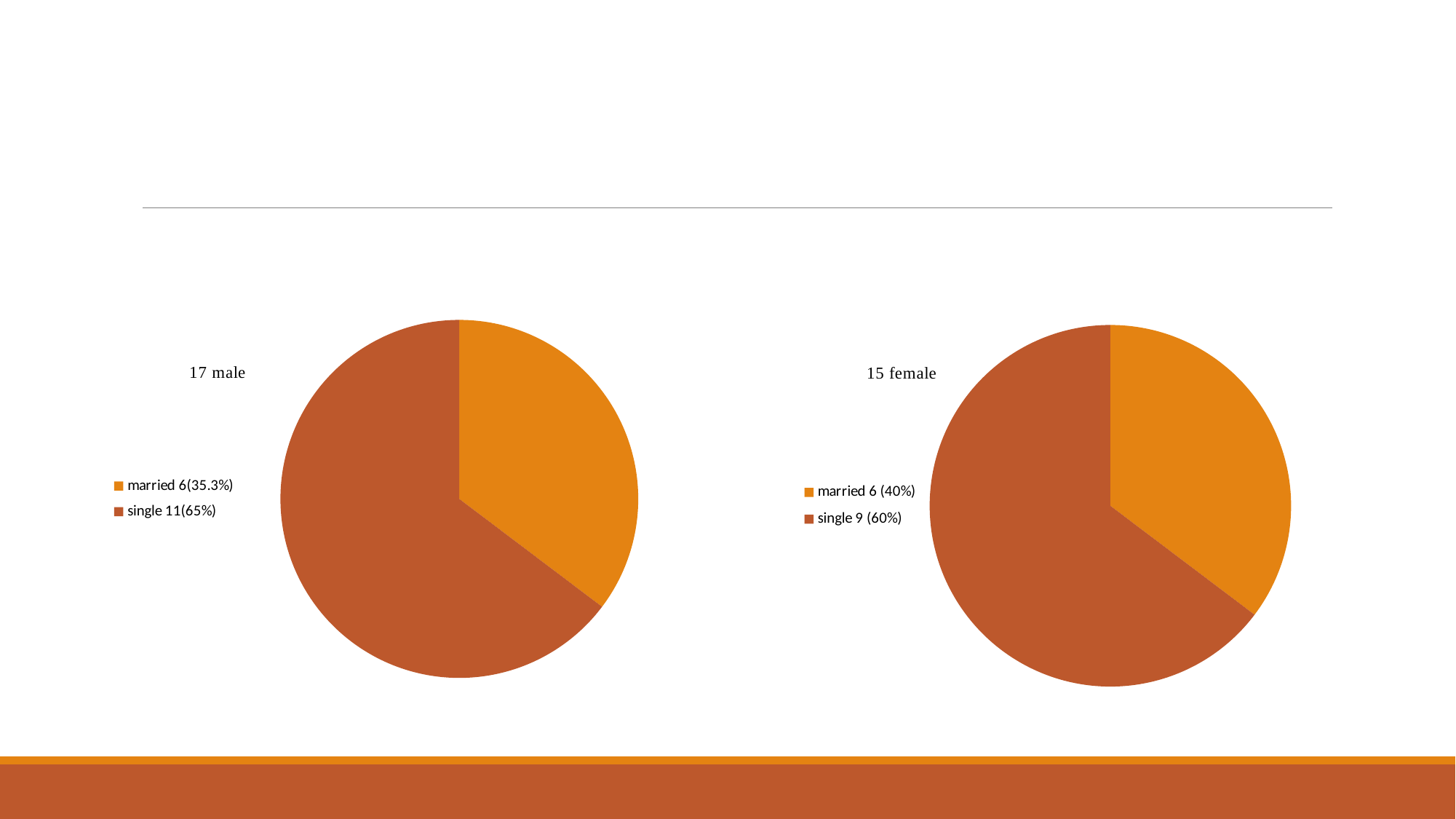
In the left pie chart (17 male), how many males are single? 11 In the right pie chart (15 female), which category is the largest slice? single In the right pie chart (15 female), how many females are married? 6 In the left pie chart (17 male), what percentage of males are married? 35.3% What type of chart is used on the left side of the slide (17 male)? pie chart In the right pie chart (15 female), which is larger: the number of single females or married females? single In the left pie chart (17 male), which category is the smallest slice? married How many slices does the right pie chart (15 female) have? 2 In the left pie chart (17 male), what percentage of males are single? 65% In the right pie chart (15 female), what percentage of females are single? 60% What label appears to the left of the right pie chart? 15 female In the left pie chart (17 male), what is the difference between the number of single and married males? 5